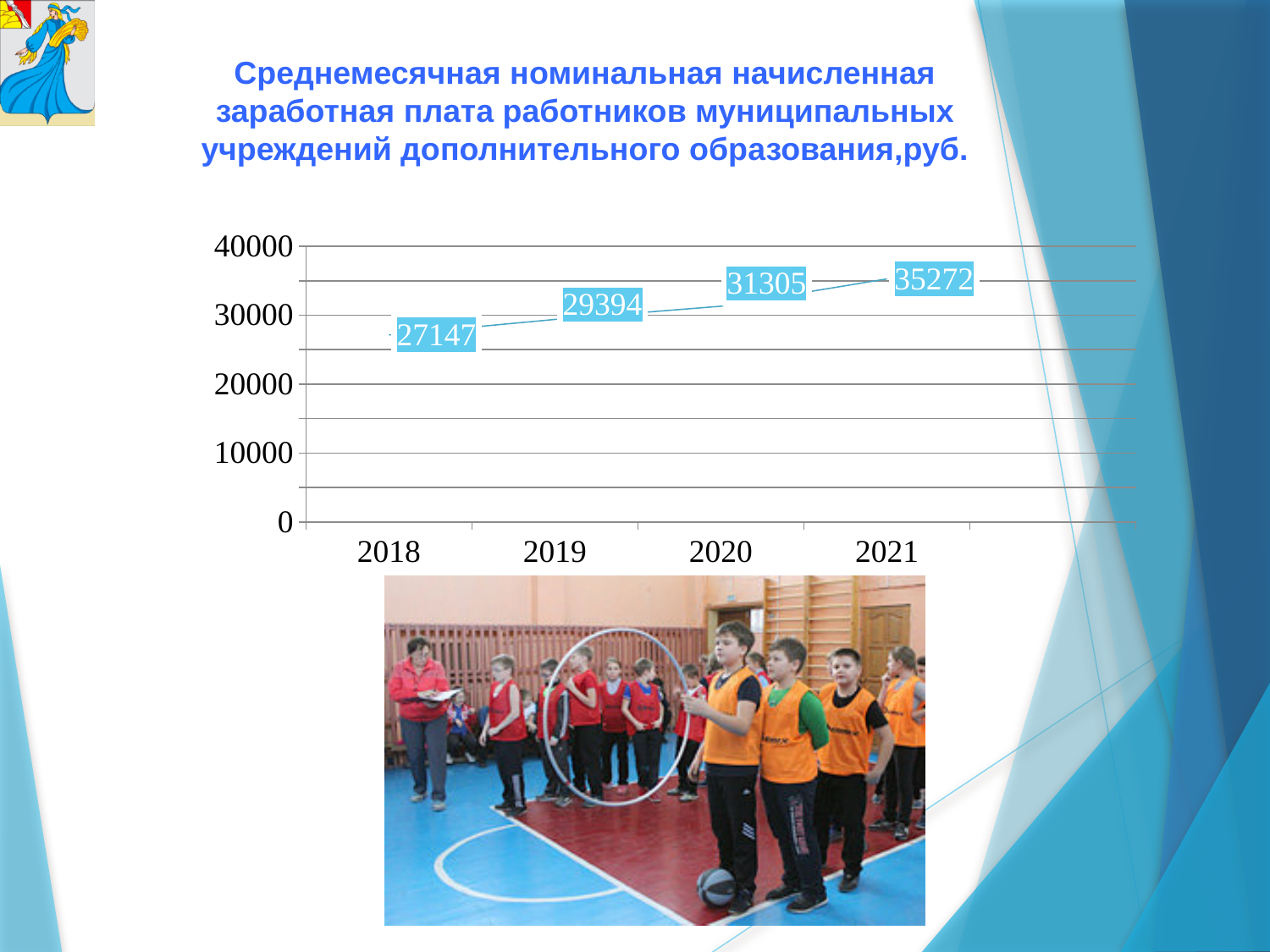
How many years are plotted on the chart? 4 What was the average monthly nominal salary in 2021? 35272 What is the difference between the 2020 and 2019 values? 1911 Which is larger, the value for 2019 or the value for 2020? 2020 Which year has the highest salary value? 2021 By how much did the salary increase from 2018 to 2021? 8125 What was the average monthly nominal salary in 2018? 27147 Which year has the lowest salary value? 2018 What kind of chart is shown on the slide? line chart Do the values rise or fall from 2018 to 2021? rise What was the average monthly nominal salary in 2019? 29394 What was the average monthly nominal salary in 2020? 31305